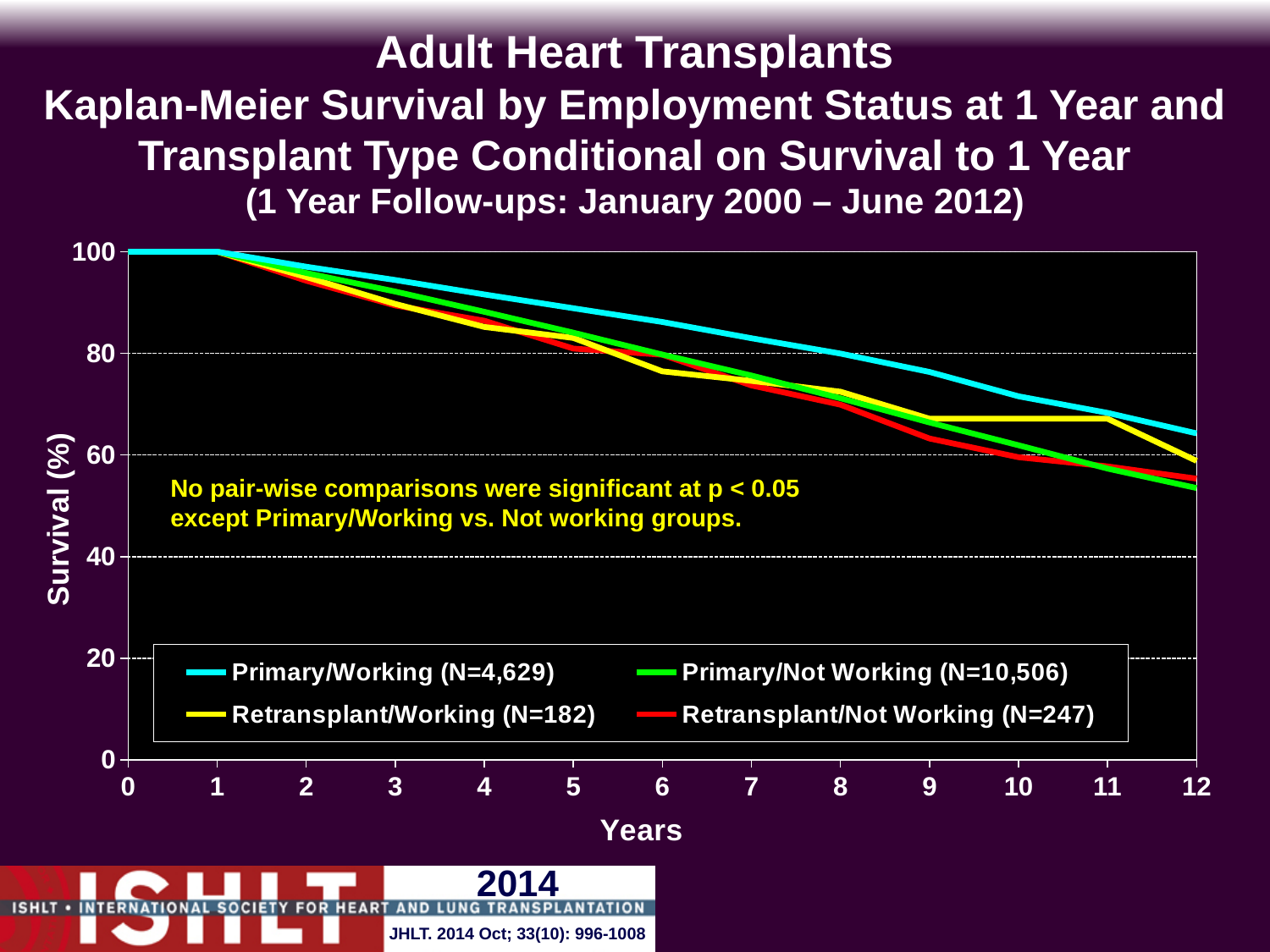
How many series does the legend list? 4 What is the survival value for all four groups at year 1? 100 Which group has the highest survival at year 12? Primary/Working What is the N for the Primary/Not Working group shown in the legend? N=10,506 Is the survival value for Retransplant/Working at year 6 greater or less than 80? less Which colour represents the Retransplant/Not Working group? red Is the survival value for Primary/Working at year 6 greater or less than 80? greater At year 12, which is higher: Primary/Working or Primary/Not Working? Primary/Working What kind of chart is shown on the slide? line chart Is the survival value for Primary/Working at year 12 greater or less than 60? greater Do the survival curves rise or fall as years increase? fall